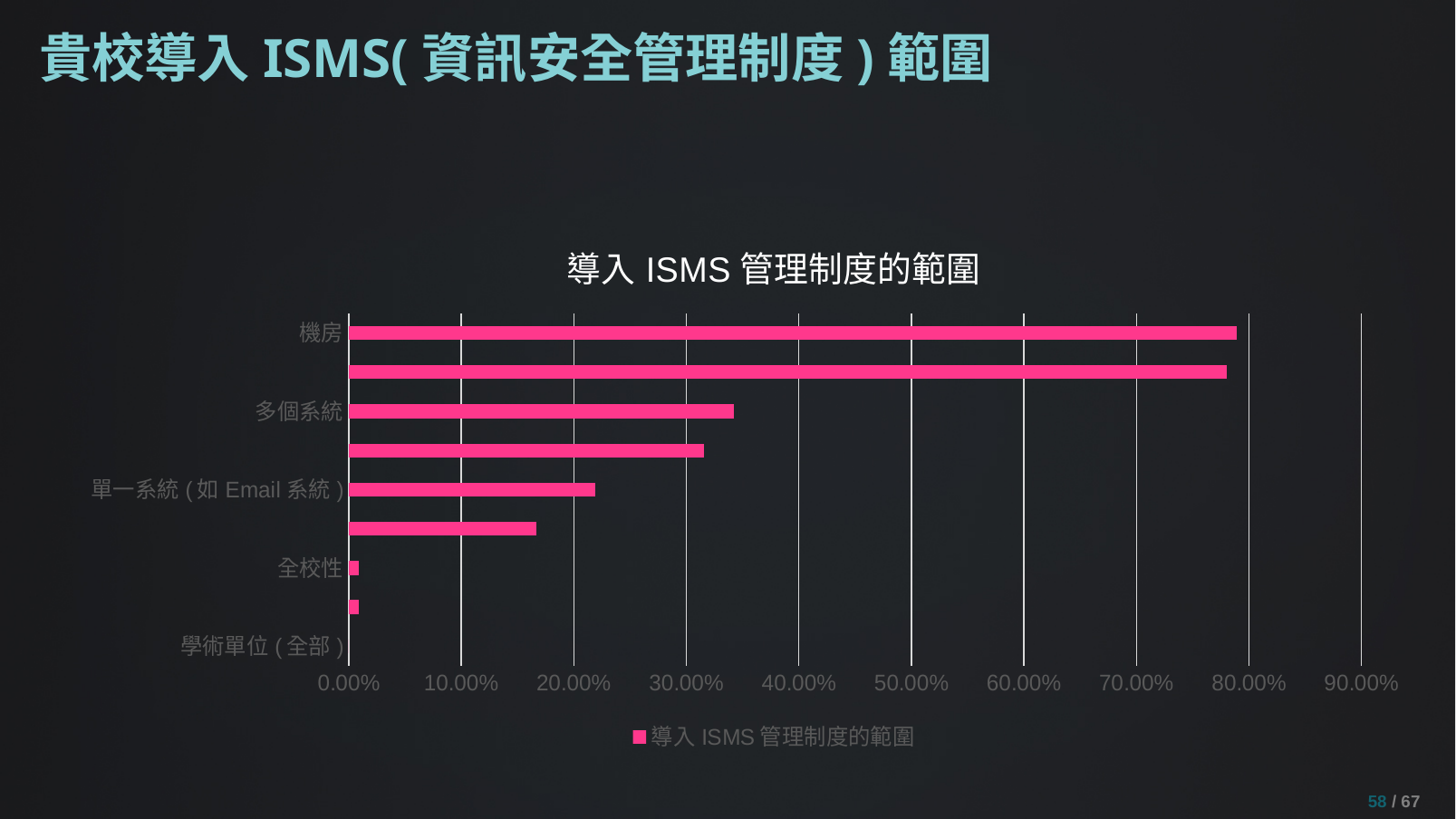
Which is larger, the value for 機房 or the value for 多個系統? 機房 What colour are the bars in the chart? pink Is the value for 機房 greater or less than 70.00%? greater Is the value for 全校性 greater or less than 10.00%? less Is the value for 多個系統 greater or less than 40.00%? less Which labelled category has the highest value? 機房 What kind of chart is shown on the slide? bar chart How many series does the legend list? 1 Which is larger, the value for 多個系統 or the value for 單一系統 (如 Email 系統)? 多個系統 What is the title of the chart? 導入 ISMS 管理制度的範圍